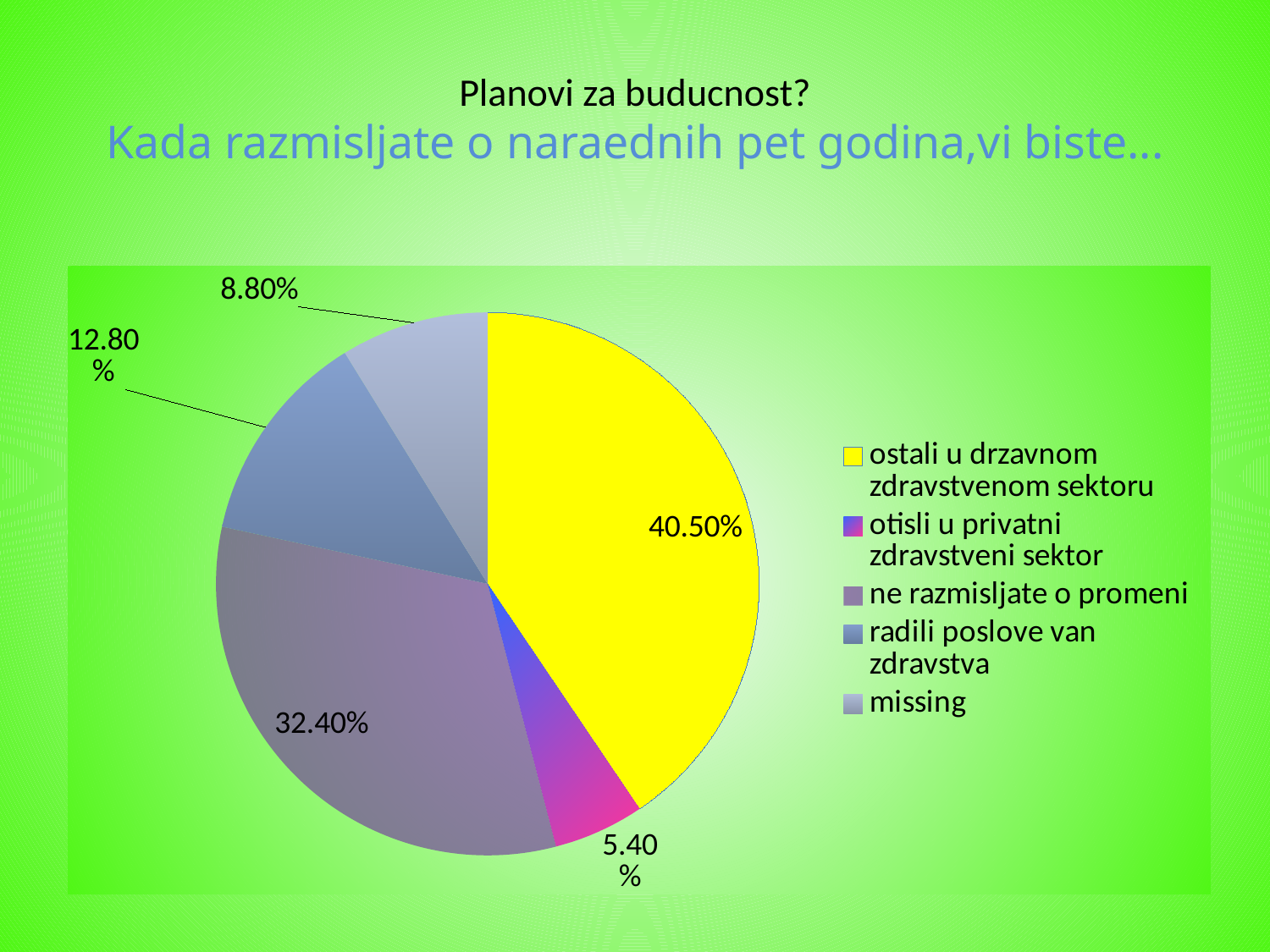
What is the difference between the shares for 'ostali u drzavnom zdravstvenom sektoru' and 'ne razmisljate o promeni'? 8.10% What colour is the slice for 'ostali u drzavnom zdravstvenom sektoru'? yellow What type of chart is shown on the slide? pie chart What percentage is shown for the 'missing' slice? 8.80% What percentage is shown for 'ne razmisljate o promeni'? 32.40% What percentage is shown for 'otisli u privatni zdravstveni sektor'? 5.40% What percentage of respondents would stay in the state health sector (ostali u drzavnom zdravstvenom sektoru)? 40.50% What percentage is shown for 'radili poslove van zdravstva'? 12.80% Which category has the smallest share of the pie? otisli u privatni zdravstveni sektor How many slices does the pie chart have? 5 Which is larger: the share for 'radili poslove van zdravstva' or the share for 'missing'? radili poslove van zdravstva Which category has the largest share of the pie? ostali u drzavnom zdravstvenom sektoru